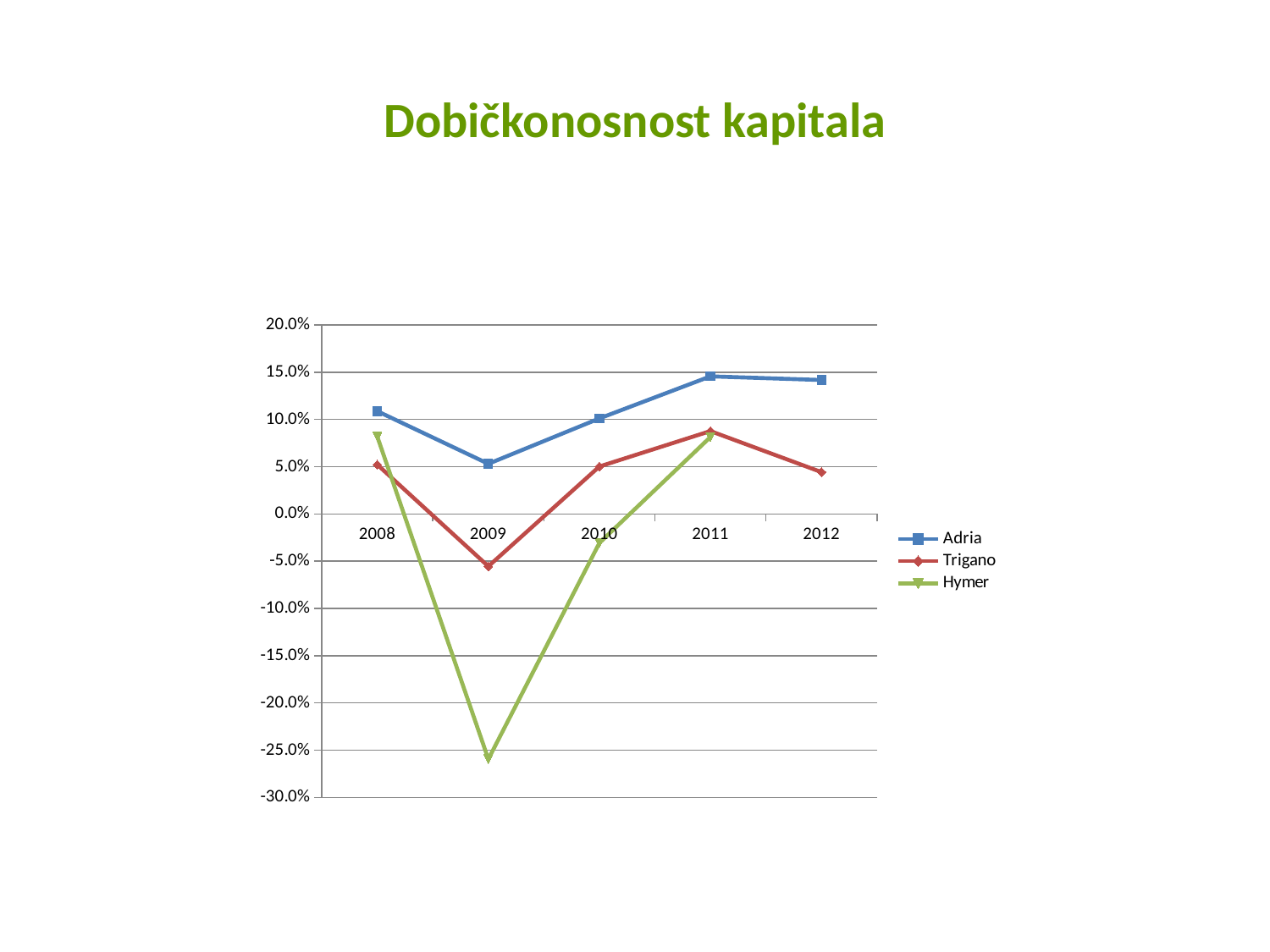
What kind of chart is shown on the slide? line chart Which colour is used for the Hymer series? green In 2010, which series has the larger value, Adria or Trigano? Adria In which year does Hymer reach its lowest value? 2009 Does the Adria series rise or fall from 2009 to 2011? rise How many series does the legend list? 3 Is the value for Adria in 2011 greater or less than 10.0%? greater Is the value for Trigano in 2009 greater or less than 0.0%? less How many years are shown on the x axis? 5 What is the title of the chart? Dobičkonosnost kapitala Is the value for Hymer in 2009 greater or less than -20.0%? less Which series has the lowest value in 2009? Hymer